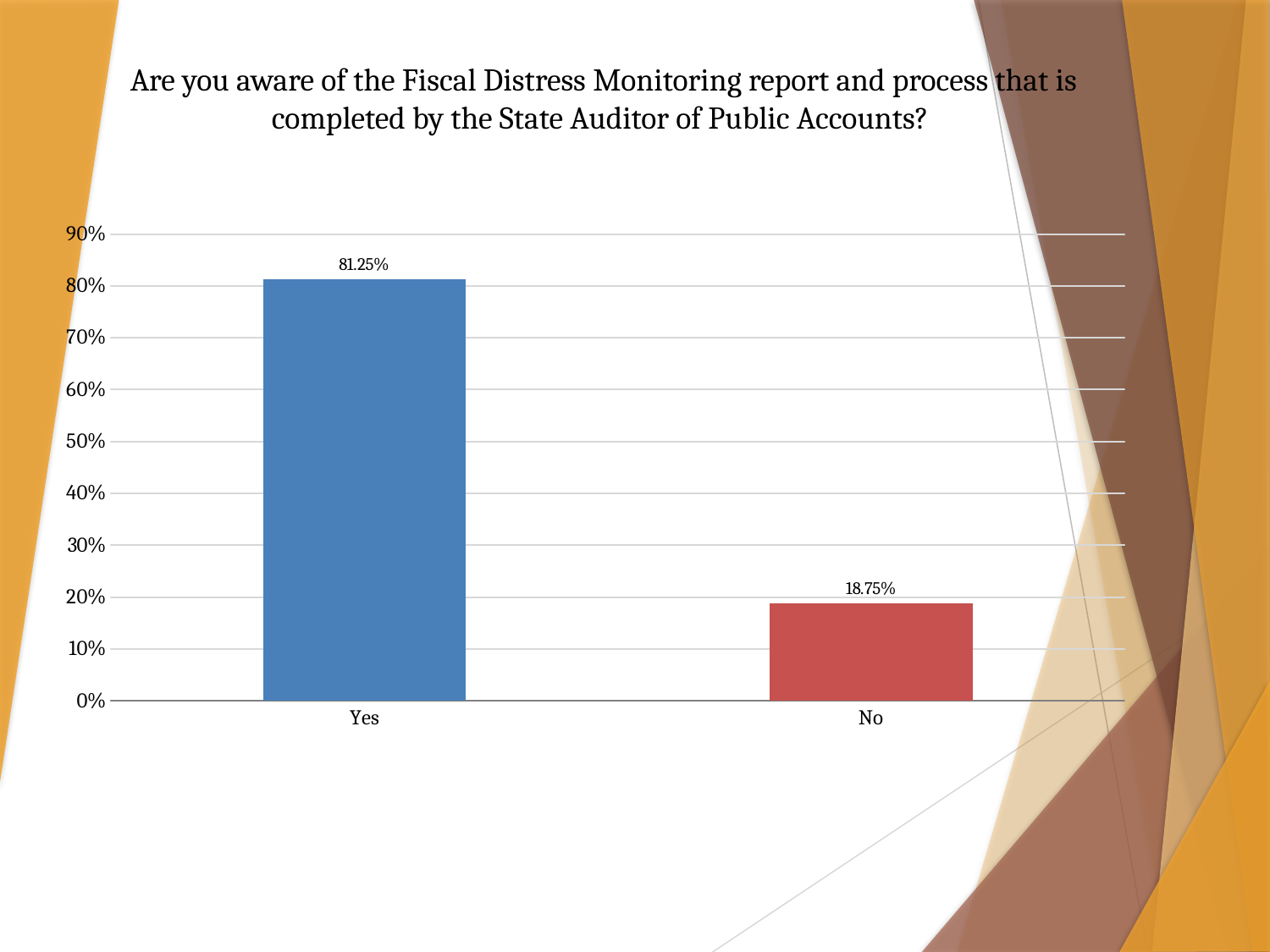
What colour is the bar for No? red What kind of chart is shown on the slide? bar chart Which response has the highest value? Yes What is the difference between the Yes and No percentages? 62.5% What is the total of the Yes and No percentages? 100% Which is larger, the value for Yes or the value for No? Yes What percentage of respondents answered No? 18.75% How many response categories are shown on the chart? 2 Is the value for Yes greater or less than 80%? greater What percentage of respondents answered Yes? 81.25% Which response has the lowest value? No Is the value for No greater or less than 20%? less